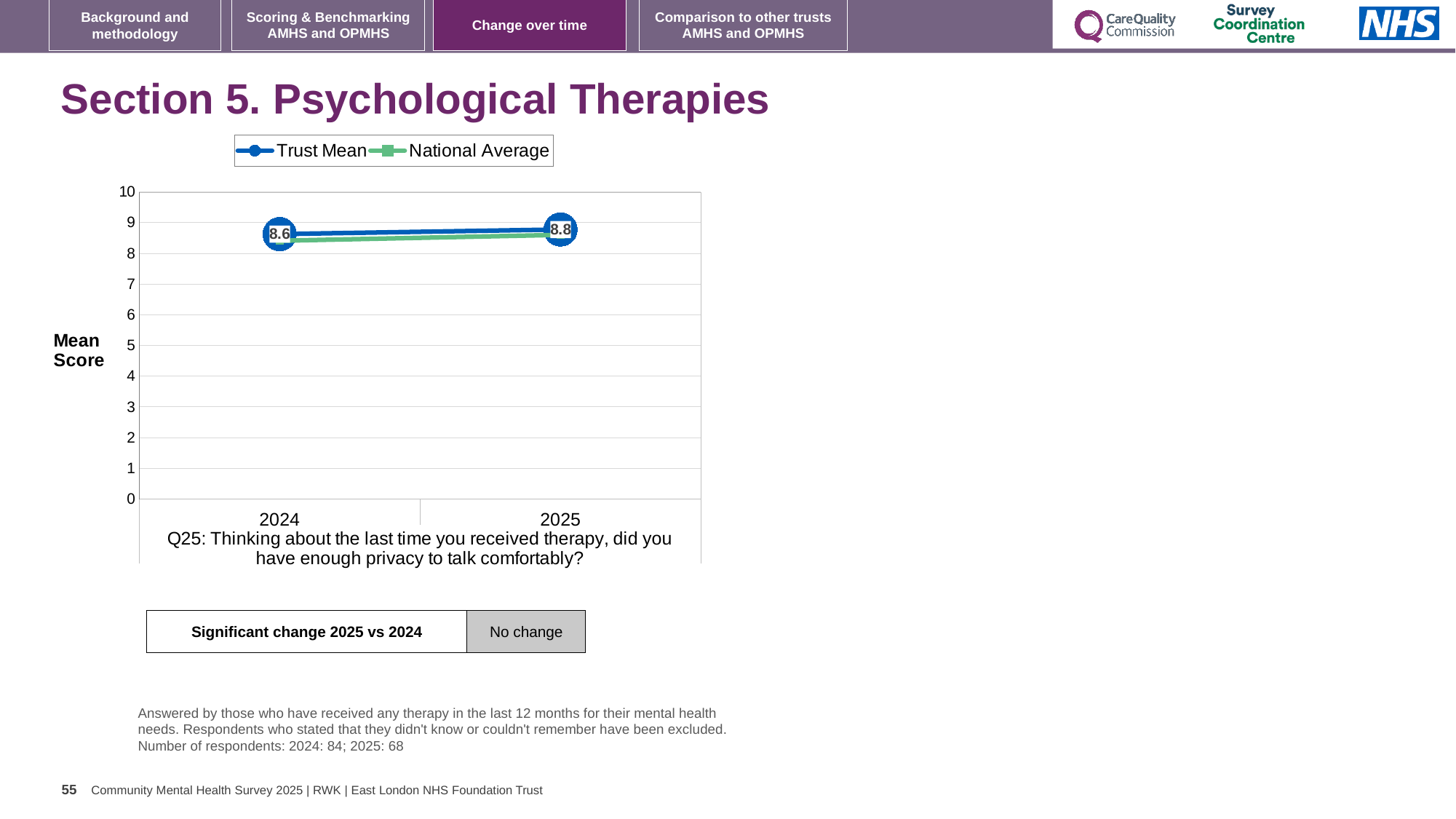
What kind of chart is shown on the slide? line chart In which year is the Trust Mean highest? 2025 How many years are plotted on the x axis? 2 What is the difference between the Trust Mean in 2025 and in 2024? 0.2 Which is larger, the Trust Mean for 2024 or for 2025? 2025 How many series does the legend list? 2 What is the Trust Mean value for 2024? 8.6 In which year is the Trust Mean lowest? 2024 Is the National Average value for 2024 greater or less than 7? greater What is the label on the y axis of the chart? Mean Score Does the Trust Mean rise or fall from 2024 to 2025? rise What is the Trust Mean value for 2025? 8.8